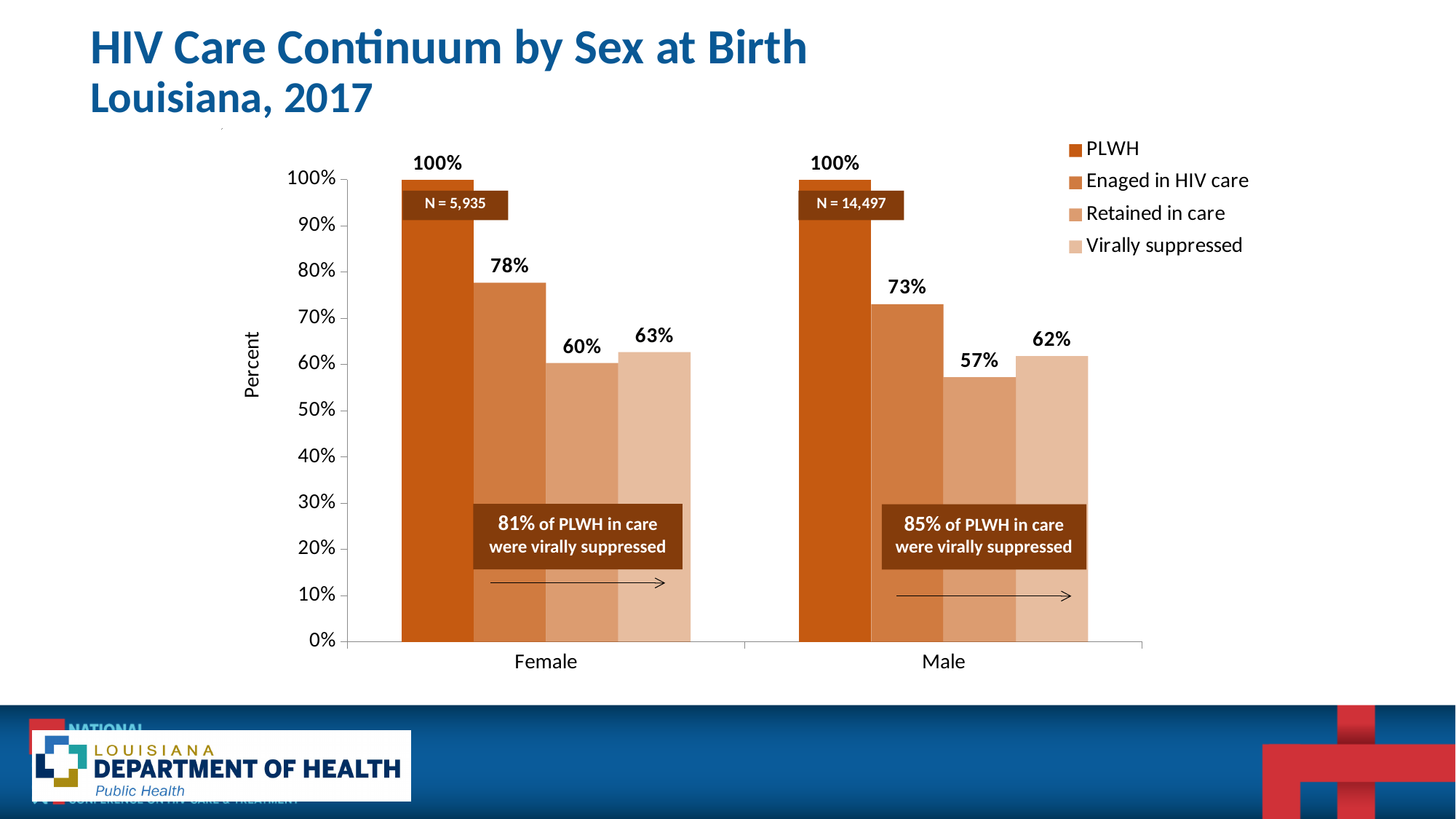
What is the label on the y axis? Percent What is the N value shown for males? N = 14,497 What kind of chart is shown on the slide? Bar chart What percentage of males were retained in care? 57% How many categories are shown on the x axis? 2 Which sex has the higher Retained in care percentage? Female What is the difference between the Engaged in HIV care percentages for females and males? 5% What percentage of females were engaged in HIV care? 78% Which series has the lowest value for males? Retained in care What percentage of male PLWH in care were virally suppressed, according to the callout box? 85% How many series does the legend list? 4 What percentage of females were virally suppressed? 63%